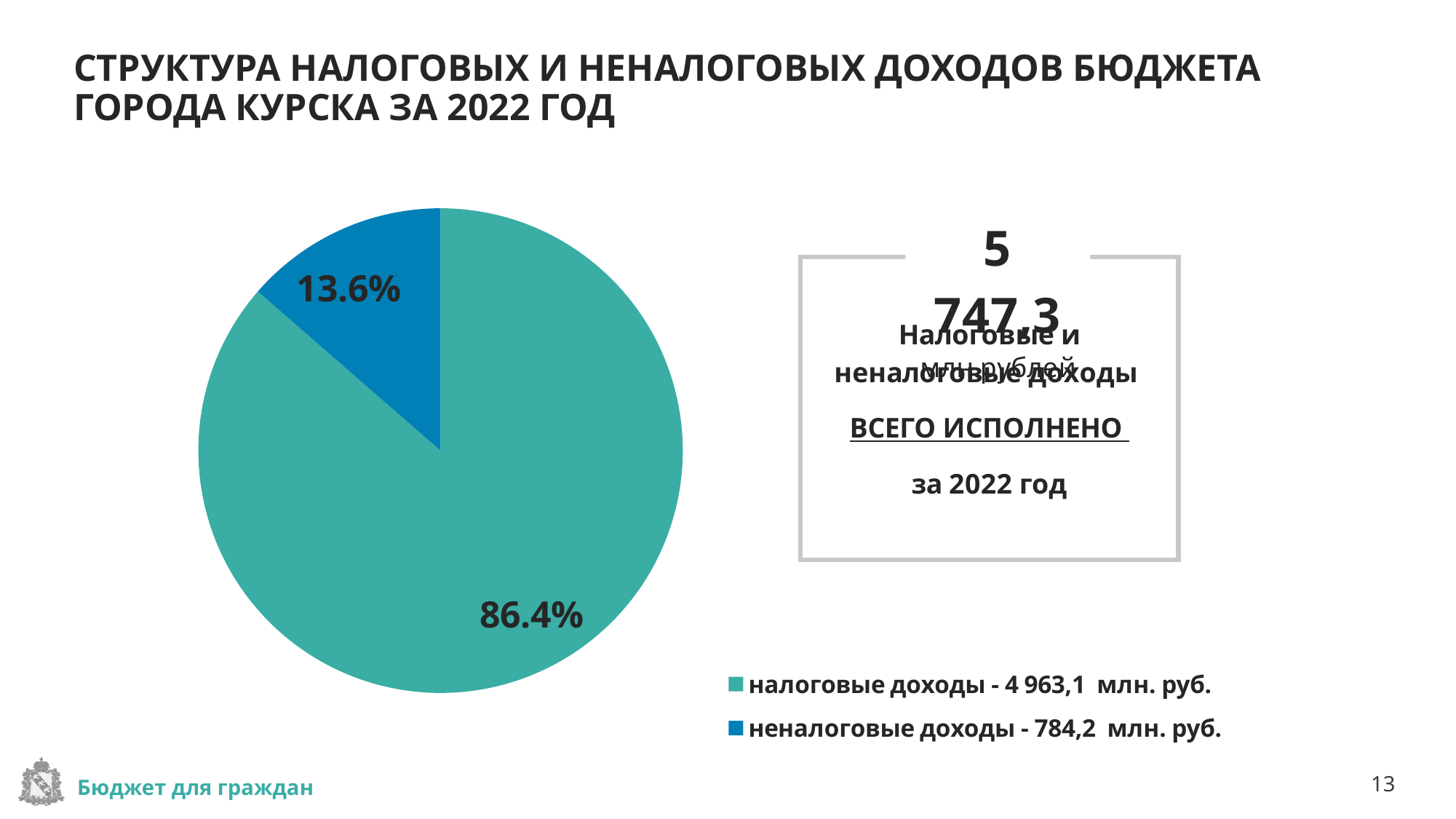
According to the legend, what is the amount for налоговые доходы? 4 963,1 млн. руб. How many slices does the pie chart have? 2 What share of the pie is labelled for налоговые доходы? 86.4% What share of the pie is labelled for неналоговые доходы? 13.6% Which is larger, the share for налоговые доходы or the share for неналоговые доходы? налоговые доходы Which slice of the pie is the largest? налоговые доходы What colour is the slice for неналоговые доходы? blue What is the difference in percentage points between the налоговые доходы slice and the неналоговые доходы slice? 72.8 Which slice of the pie is the smallest? неналоговые доходы How many entries does the legend list? 2 According to the legend, what is the amount for неналоговые доходы? 784,2 млн. руб. What kind of chart is shown on the slide? pie chart